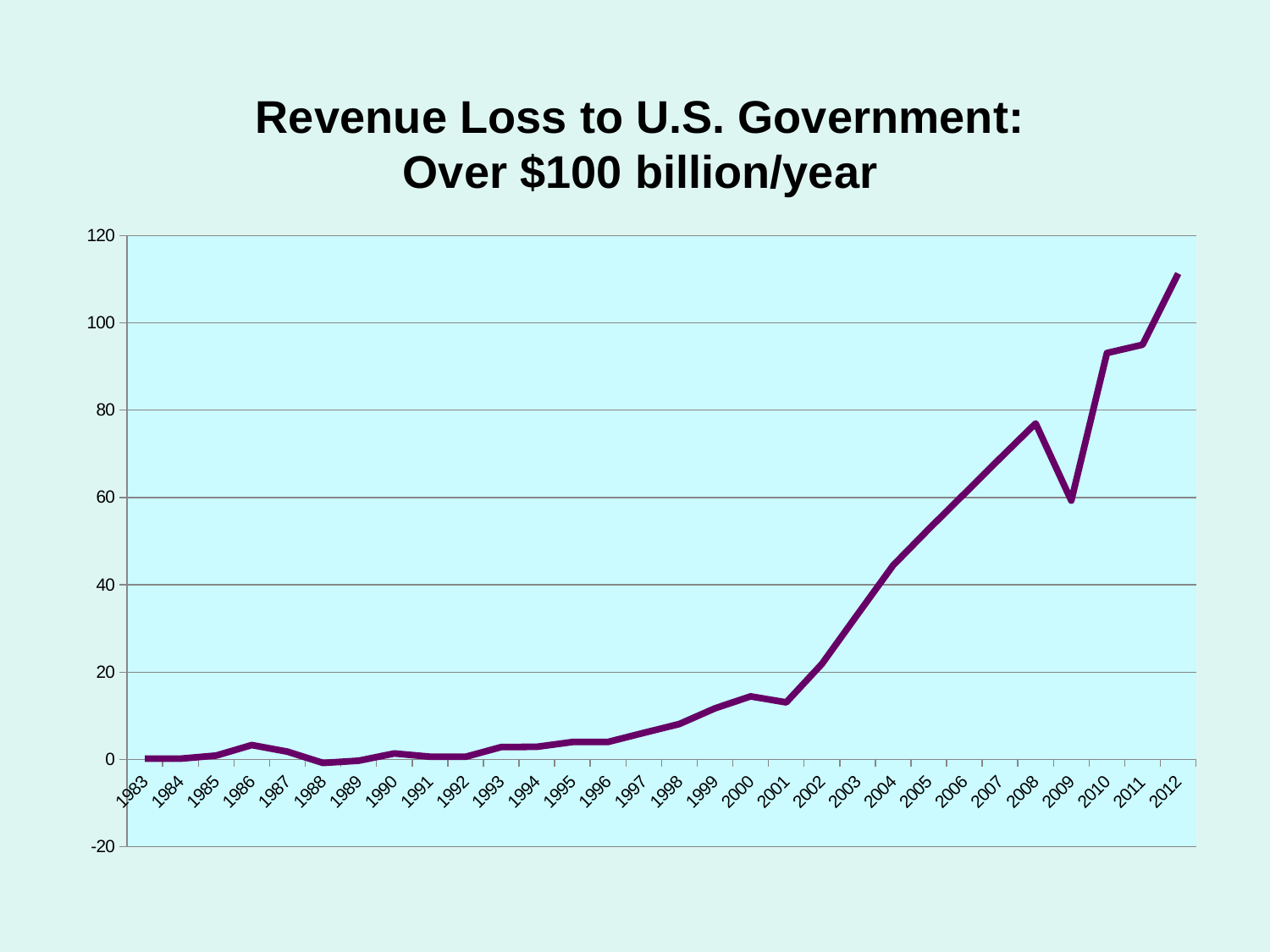
What kind of chart is shown on the slide? line chart Is the value for 2008 greater or less than 80? less Is the value for 2010 greater or less than 80? greater Overall, do the values rise or fall from 1983 to 2012? rise Is the value for 2001 greater or less than 20? less What is the title of the chart? Revenue Loss to U.S. Government: Over $100 billion/year Which year has the highest value on the chart? 2012 How many years are plotted along the x axis? 30 Which year has the larger value, 2003 or 2006? 2006 Which year has the larger value, 2008 or 2009? 2008